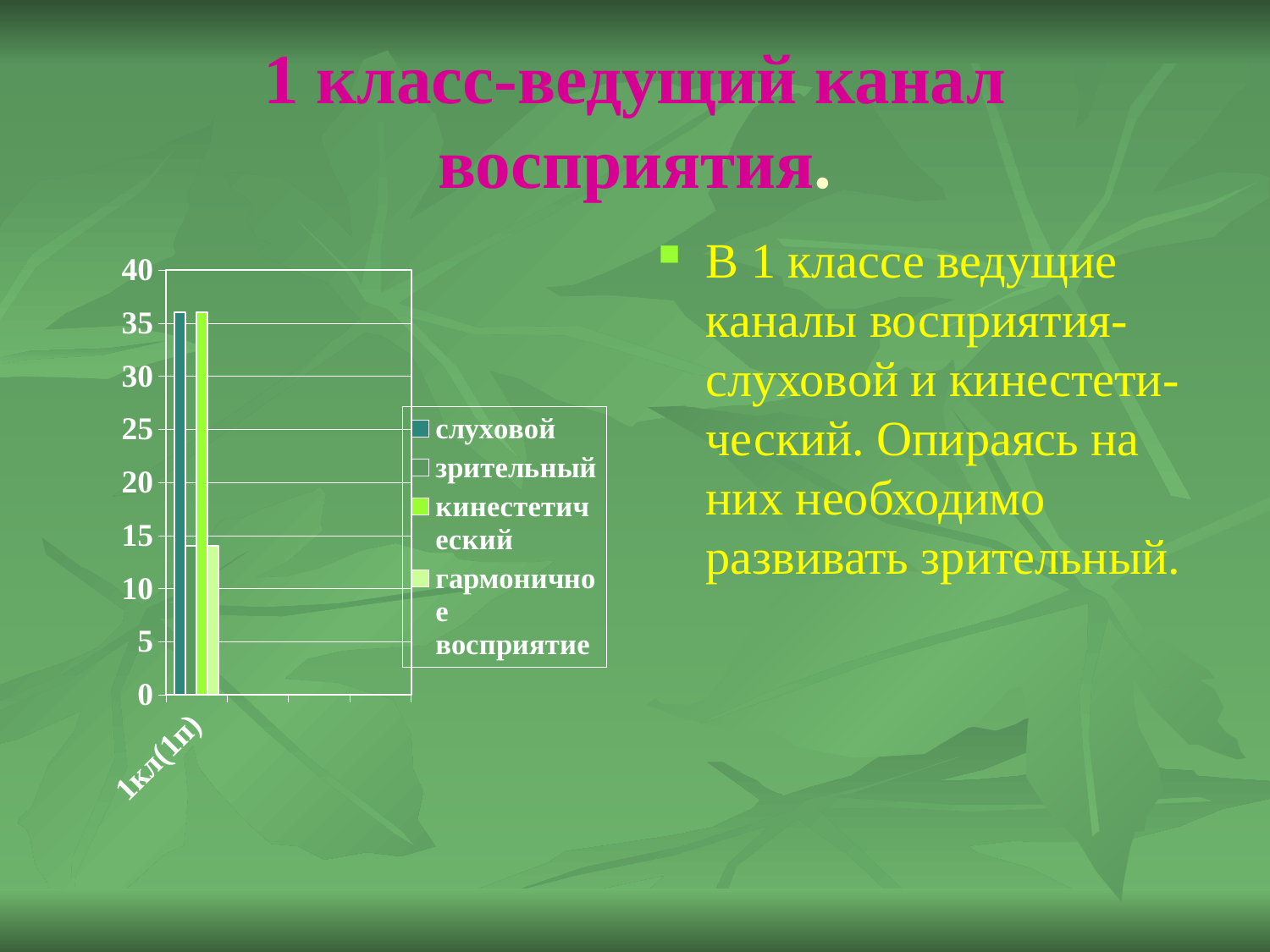
What is the label of the category on the x axis of the chart? 1кл(1п) Is the value for гармоничное восприятие greater or less than 20? less Which is larger, the value for слуховой or the value for гармоничное восприятие? слуховой Is the value for кинестетический greater or less than 30? greater What kind of chart is shown on the slide? bar chart Which is larger, the value for кинестетический or the value for гармоничное восприятие? кинестетический Is the value for слуховой greater or less than 30? greater How many series does the chart legend list? 4 How many categories are shown on the x axis of the chart? 1 What is the highest value shown on the vertical axis of the chart? 40